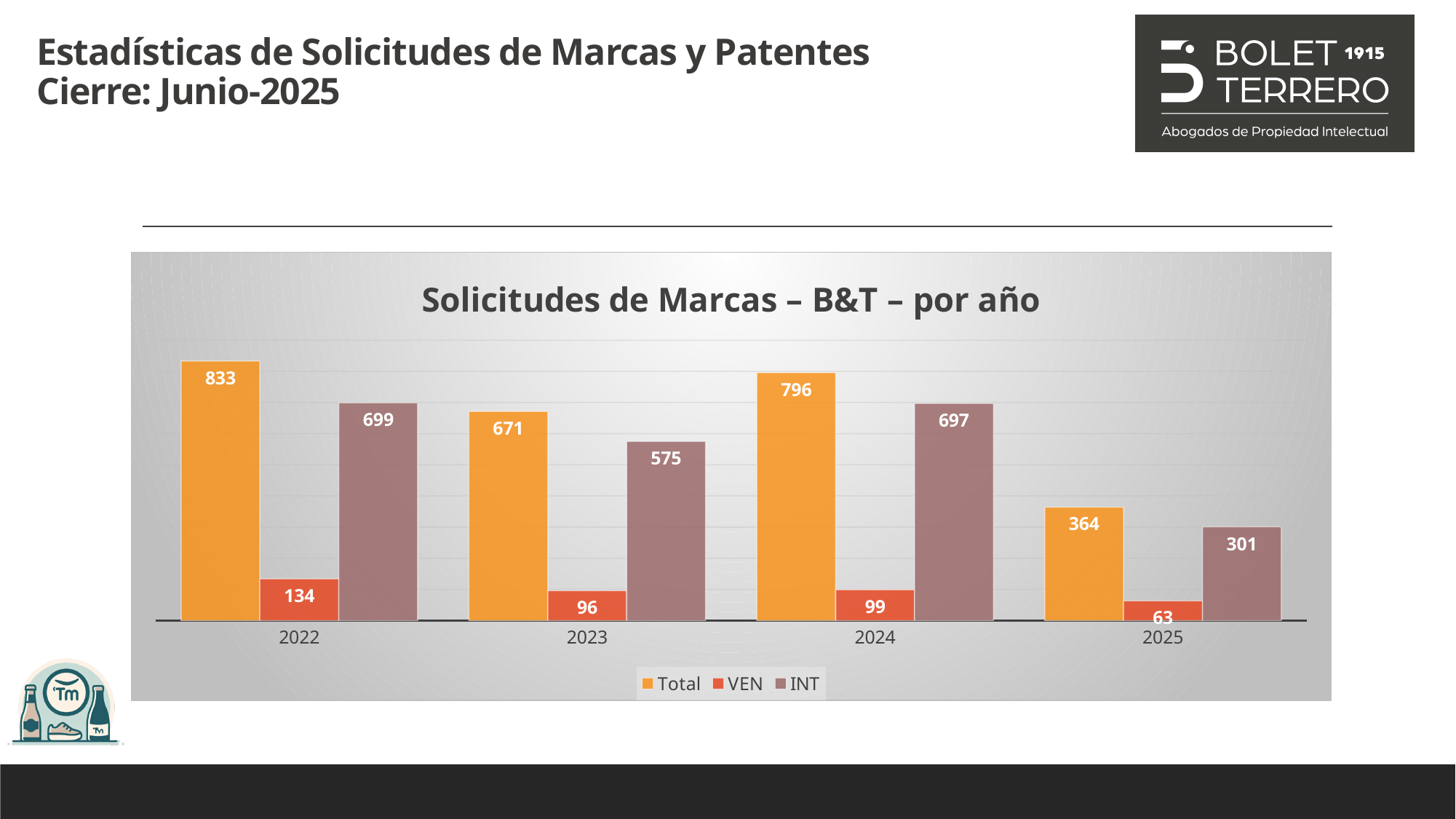
How many series does the legend list? 3 How many years are shown on the x axis? 4 Which year has the lowest INT value? 2025 Which year has the highest Total value? 2022 What is the INT value for 2024? 697 What is the difference between the INT and VEN values for 2024? 598 Which is larger, the INT value for 2022 or the INT value for 2024? INT value for 2022 What is the difference between the Total values for 2022 and 2023? 162 What is the VEN value for 2025? 63 What is the VEN value for 2023? 96 What is the Total value for 2022? 833 What type of chart is shown? Bar chart